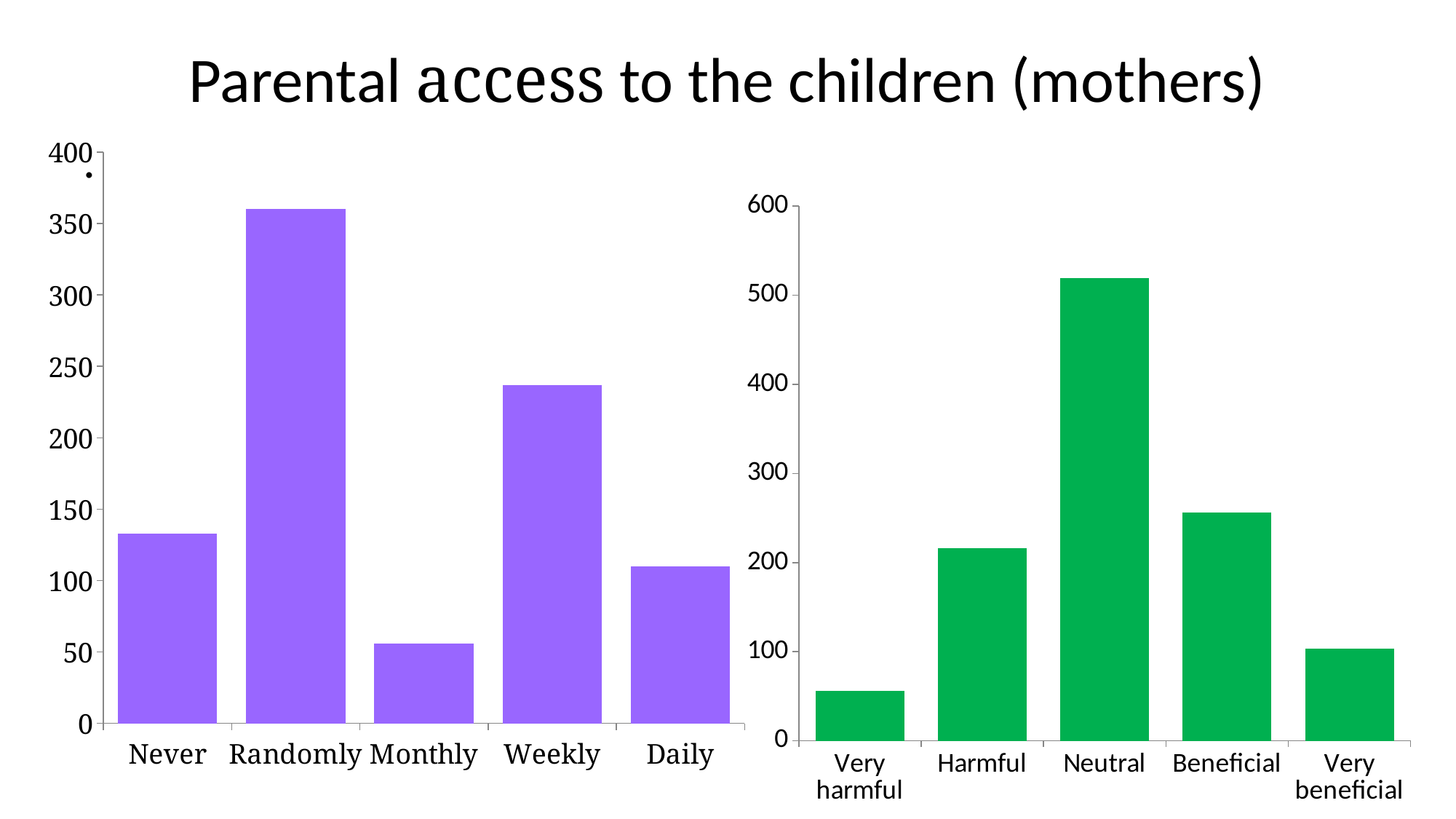
In the left chart, which is larger, the value for Never or the value for Daily? Never In the left chart, is the value for Never greater or less than 150? less What is the title of the slide? Parental access to the children (mothers) In the left chart, is the value for Weekly greater or less than 200? greater In the right chart, which category has the highest bar? Neutral In the right chart, which category has the lowest bar? Very harmful In the right chart, is the value for Neutral greater or less than 500? greater In the left chart, which category has the highest bar? Randomly In the right chart, which is larger, the value for Harmful or the value for Beneficial? Beneficial What kind of chart is the right chart? Bar chart In the left chart, which category has the lowest bar? Monthly How many categories are shown in the left chart? 5